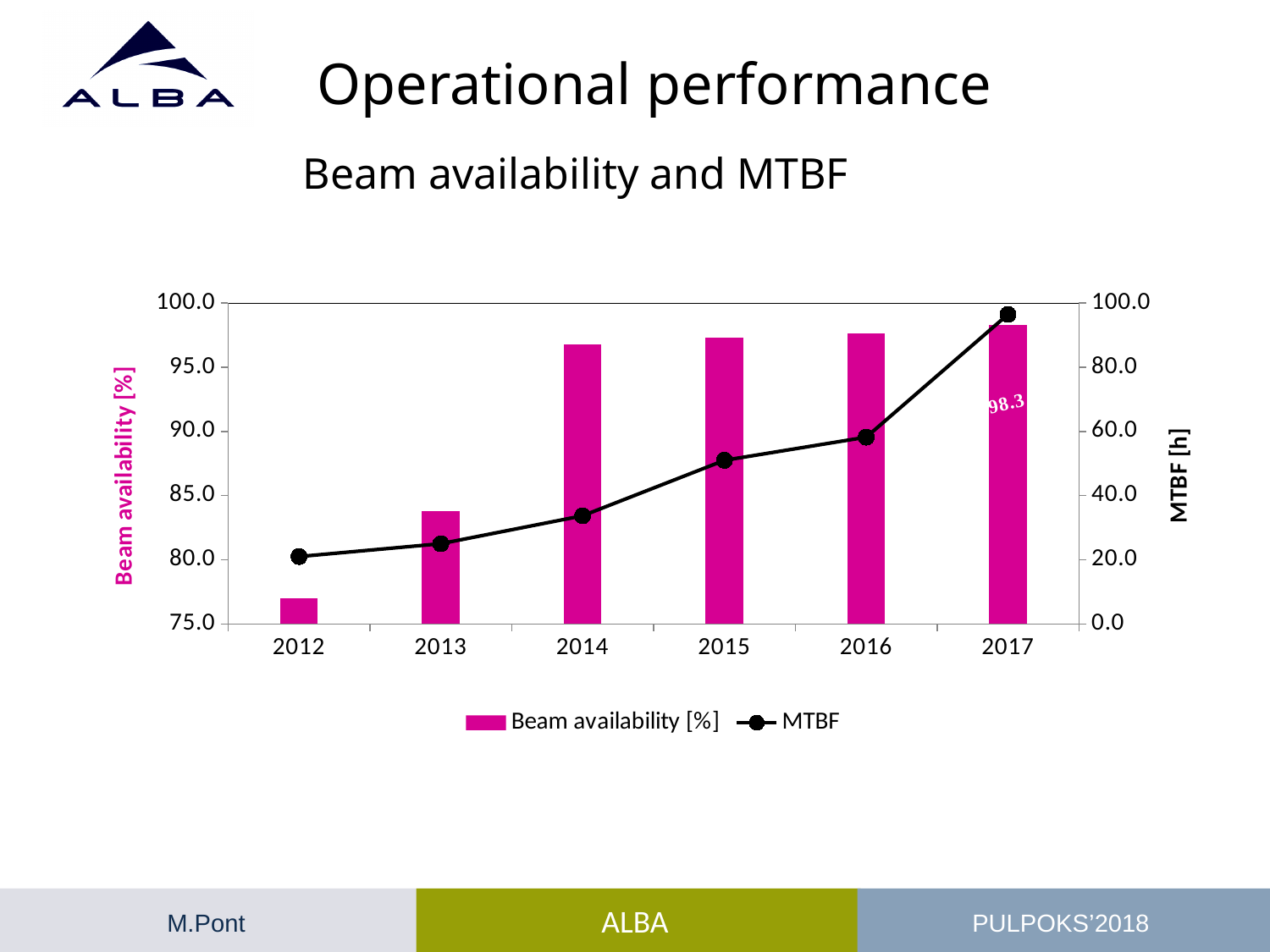
How many series does the legend list? 2 How many years are shown on the x axis of the chart? 6 Is the MTBF value for 2012 greater or less than 40.0? less What is the label of the right-hand vertical axis? MTBF [h] Is the beam availability for 2012 greater or less than 80.0? less Does the MTBF line rise or fall from 2012 to 2017? rise What is the beam availability value labelled on the bar for 2017? 98.3 Is the beam availability for 2013 greater or less than 80.0? greater Which year has the highest beam availability bar? 2017 Which year has the lowest beam availability bar? 2012 Which year has the larger beam availability bar, 2013 or 2014? 2014 Which year has the highest MTBF point? 2017